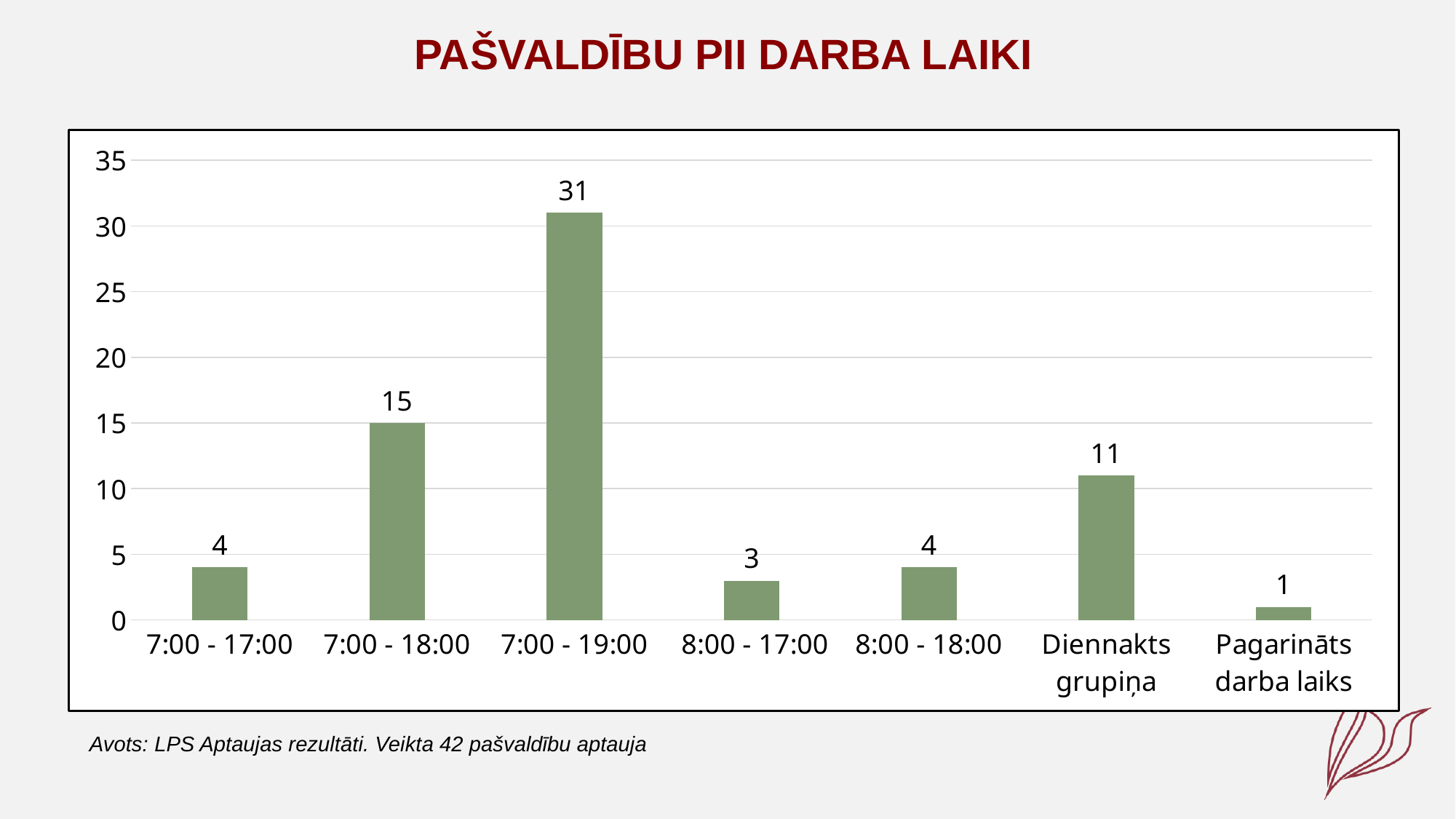
Which category has the highest value? 7:00 - 19:00 What is the difference between the values for 7:00 - 19:00 and 7:00 - 18:00? 16 What is the difference between the values for 7:00 - 17:00 and Pagarināts darba laiks? 3 Which category has the lowest value? Pagarināts darba laiks Is the value for 7:00 - 19:00 greater or less than 30? greater Which is larger, the value for Diennakts grupiņa or the value for 7:00 - 18:00? 7:00 - 18:00 What kind of chart is shown on the slide? bar chart What is the value for Diennakts grupiņa? 11 What is the value for 7:00 - 19:00? 31 How many categories are shown on the x axis? 7 What is the title of the chart? PAŠVALDĪBU PII DARBA LAIKI What is the value for 8:00 - 17:00? 3